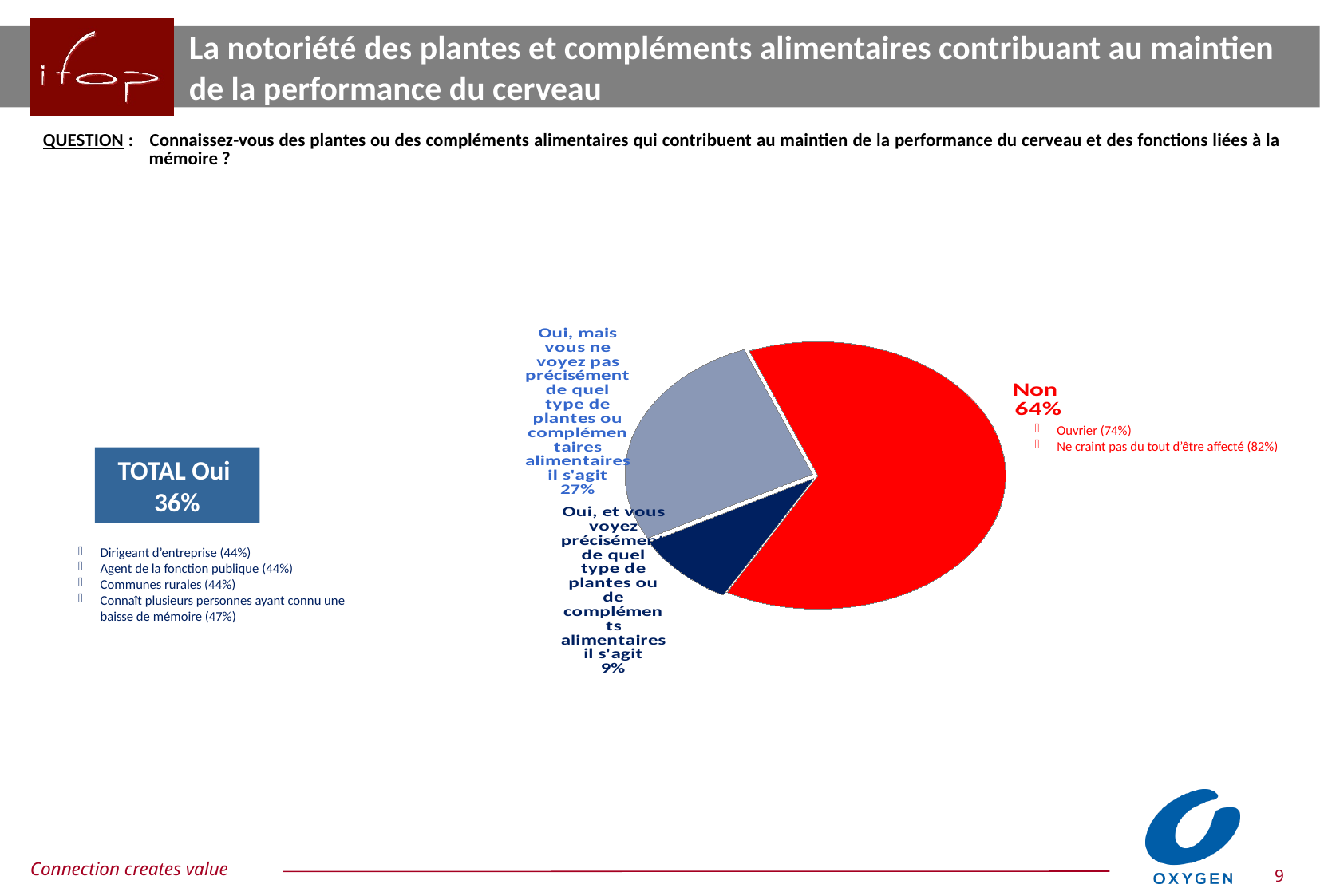
What is the value for the slice "Oui, et vous voyez précisément de quel type de plantes ou de compléments alimentaires il s'agit"? 9% What is the value for the slice "Oui, mais vous ne voyez pas précisément de quel type de plantes ou compléments alimentaires il s'agit"? 27% Which slice of the pie chart is the largest? Non Which slice of the pie chart is the smallest? Oui, et vous voyez précisément de quel type de plantes ou de compléments alimentaires il s'agit What colour is the "Non" slice of the pie chart? red What value is shown in the "TOTAL Oui" box next to the chart? 36% Which is larger: the "Oui, mais vous ne voyez pas précisément" slice or the "Oui, et vous voyez précisément" slice? Oui, mais vous ne voyez pas précisément What is the difference between the "Non" slice and the "Oui, mais vous ne voyez pas précisément" slice? 37 percentage points What is the combined share of the two "Oui" slices? 36% How many slices does the pie chart have? 3 What share of the pie is labelled "Non"? 64% What kind of chart is shown on the slide? pie chart